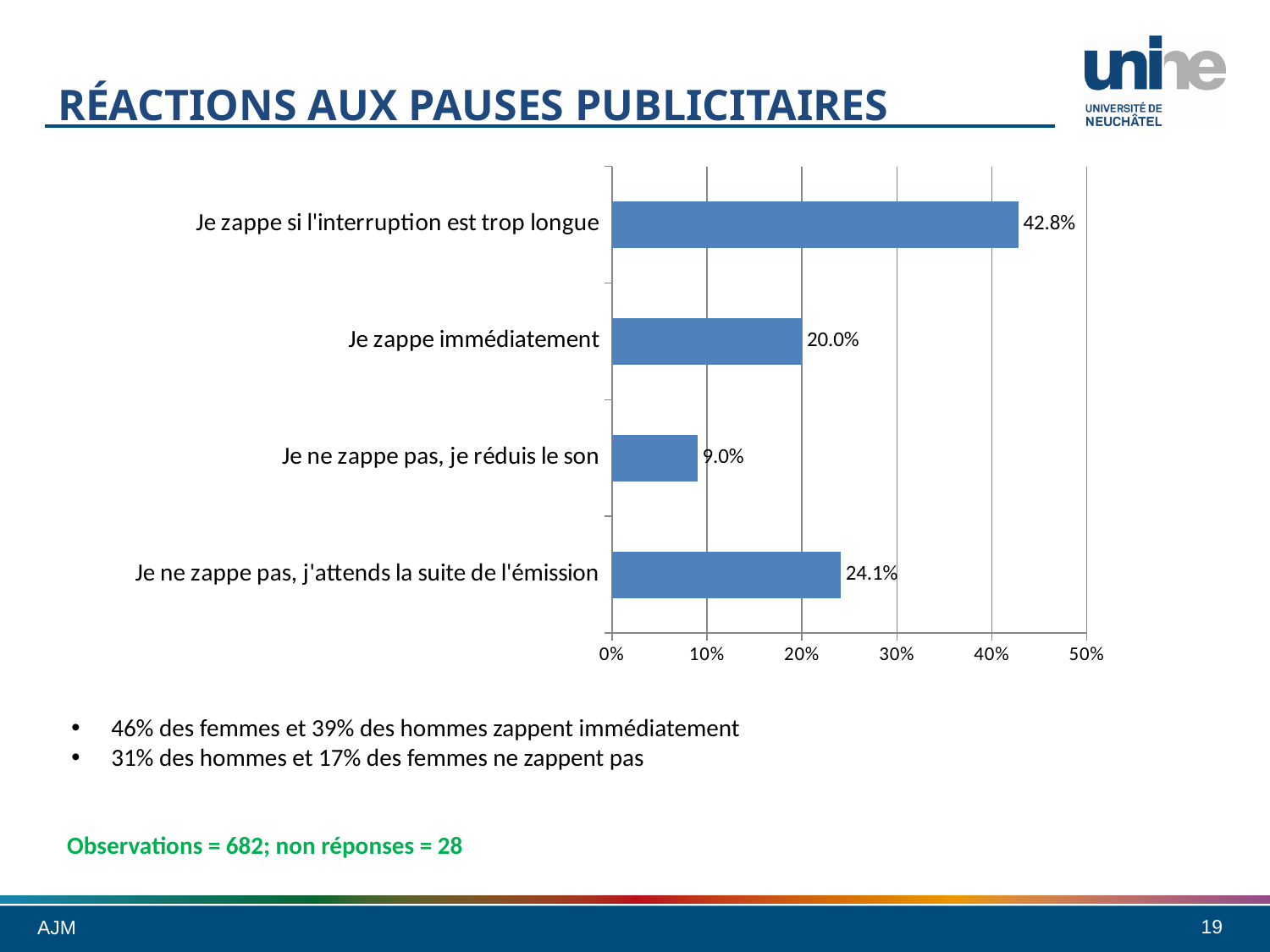
What is the value for "Je zappe immédiatement"? 20.0% Which category has the highest value? Je zappe si l'interruption est trop longue What is the value for "Je ne zappe pas, j'attends la suite de l'émission"? 24.1% What kind of chart is shown on the slide? Bar chart What is the value for "Je ne zappe pas, je réduis le son"? 9.0% Which category has the lowest value? Je ne zappe pas, je réduis le son What is the maximum value shown on the horizontal axis? 50% Which is larger: the value for "Je ne zappe pas, j'attends la suite de l'émission" or the value for "Je zappe immédiatement"? Je ne zappe pas, j'attends la suite de l'émission How many categories are shown in the chart? 4 Is the value for "Je ne zappe pas, je réduis le son" greater or less than 10%? less What is the difference between the values for "Je zappe si l'interruption est trop longue" and "Je zappe immédiatement"? 22.8% What is the value for "Je zappe si l'interruption est trop longue"? 42.8%